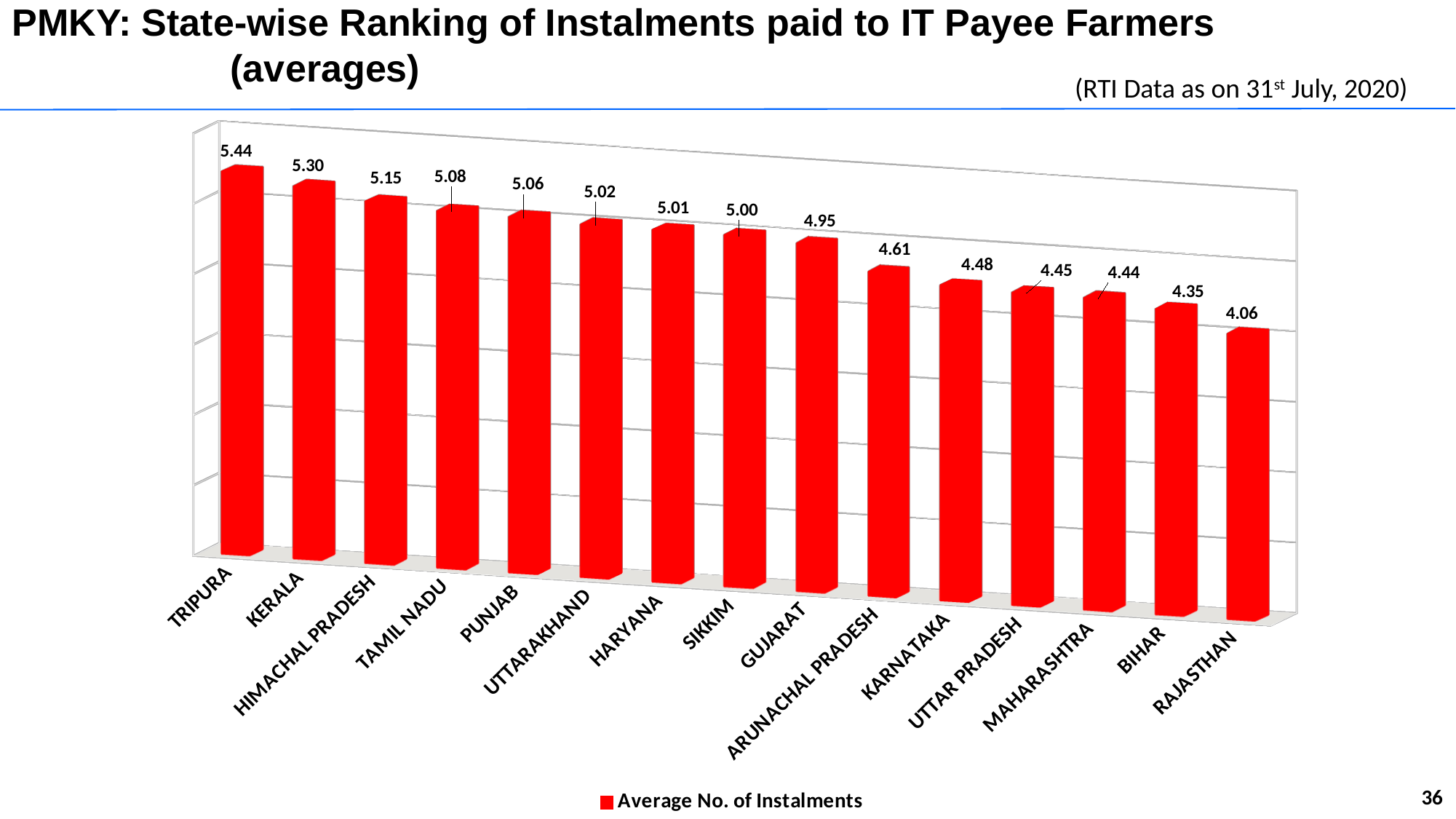
Do the values rise or fall from left to right along the x axis? Fall What is the average number of instalments for Tripura? 5.44 What is the difference between the values for Tripura and Rajasthan? 1.38 How many series does the legend list? 1 What is the difference between the values for Kerala and Bihar? 0.95 What kind of chart is shown on the slide? Bar chart Which has a higher average number of instalments, Punjab or Karnataka? Punjab What is the average number of instalments for Maharashtra? 4.44 What is the average number of instalments for Gujarat? 4.95 Which state has the lowest average number of instalments? Rajasthan Which state has the highest average number of instalments? Tripura How many states are shown in the chart? 15